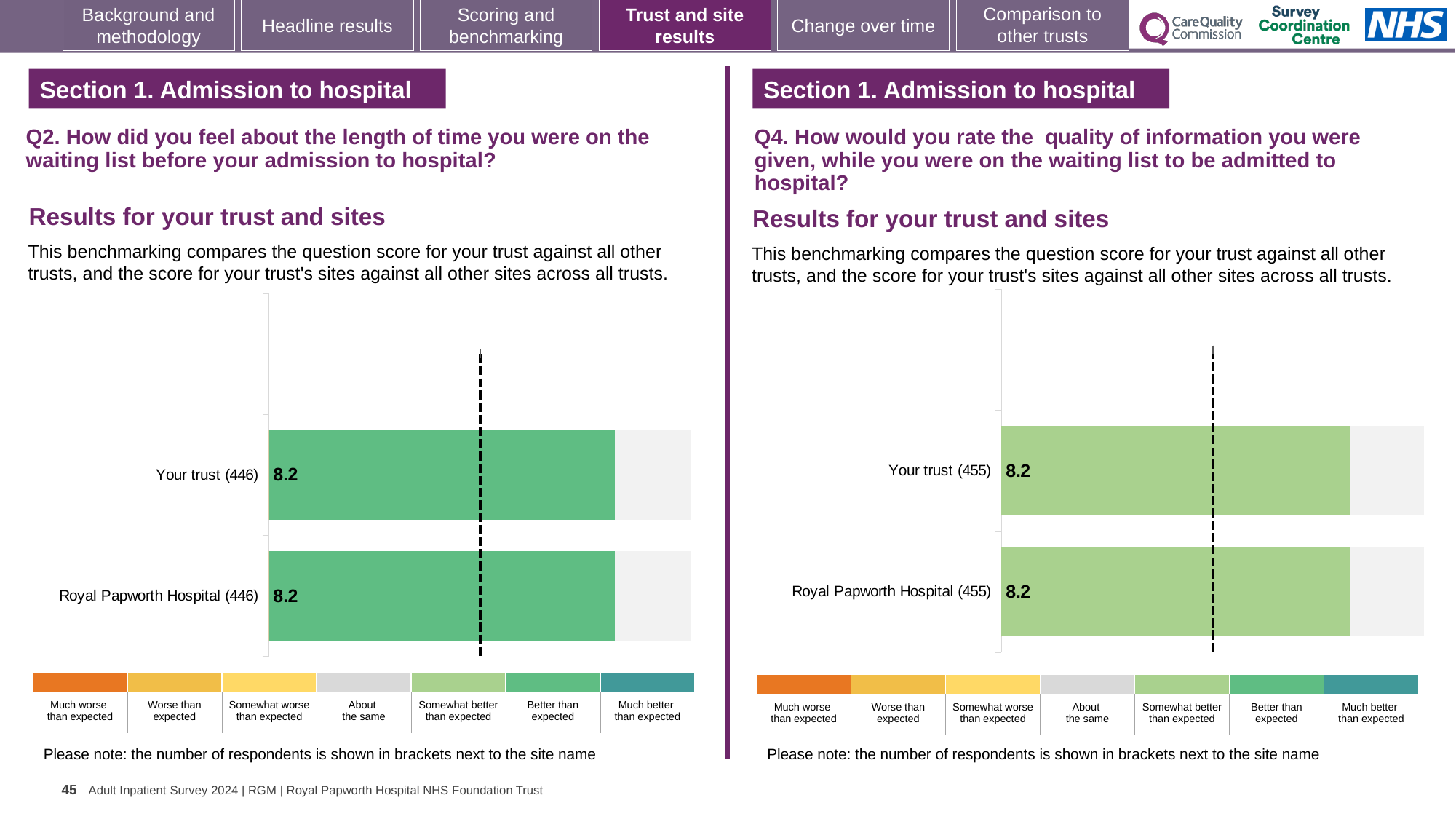
On the left chart (Q2), how many respondents are shown in brackets next to Your trust? 446 On the left chart (Q2), what is the score for Royal Papworth Hospital? 8.2 According to the colour key, which benchmark category do the bars on the right chart (Q4) fall into? Somewhat better than expected On the right chart (Q4), what is the score for Your trust? 8.2 On the right chart (Q4), how many respondents are shown in brackets next to Royal Papworth Hospital? 455 On the right chart (Q4), what is the score for Royal Papworth Hospital? 8.2 How many bars are plotted on the left chart (Q2)? 2 On the left chart (Q2), what is the score for Your trust? 8.2 On the right chart (Q4), what is the difference between the score for Your trust and the score for Royal Papworth Hospital? 0 On the left chart (Q2), what is the difference between the score for Your trust and the score for Royal Papworth Hospital? 0 How many bars are plotted on the right chart (Q4)? 2 What kind of chart is used on the left (Q2)? Bar chart